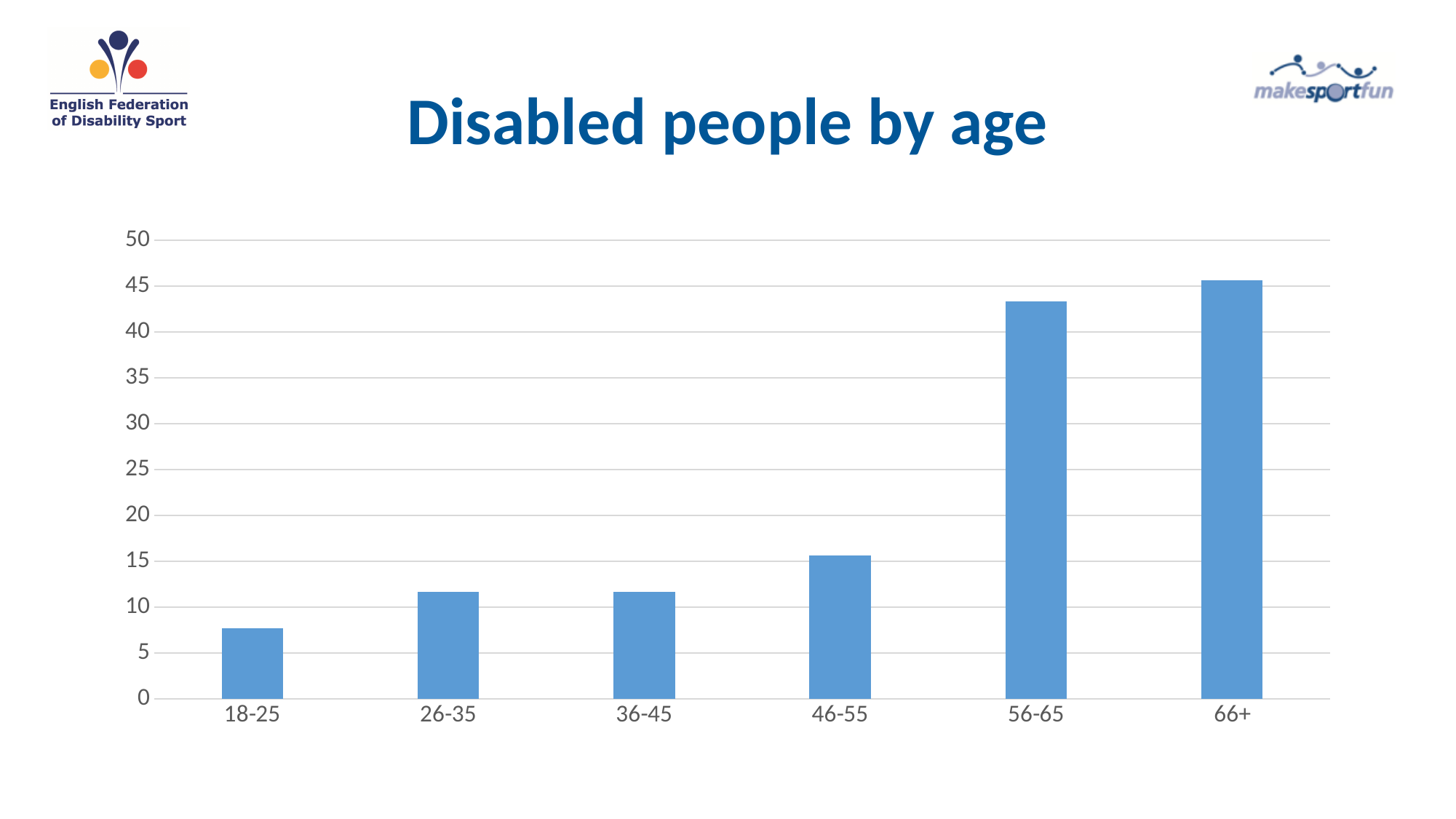
How many age categories are shown on the x axis? 6 Is the value for 46-55 greater or less than 20? less What kind of chart is shown on the slide? bar chart Which age group has the lowest value? 18-25 Is the value for 56-65 greater or less than 40? greater Which has the larger value, 46-55 or 36-45? 46-55 Is the value for 18-25 greater or less than 10? less Do the values generally rise or fall as age increases along the x axis? rise Which age group has the highest value? 66+ What is the title of the chart? Disabled people by age